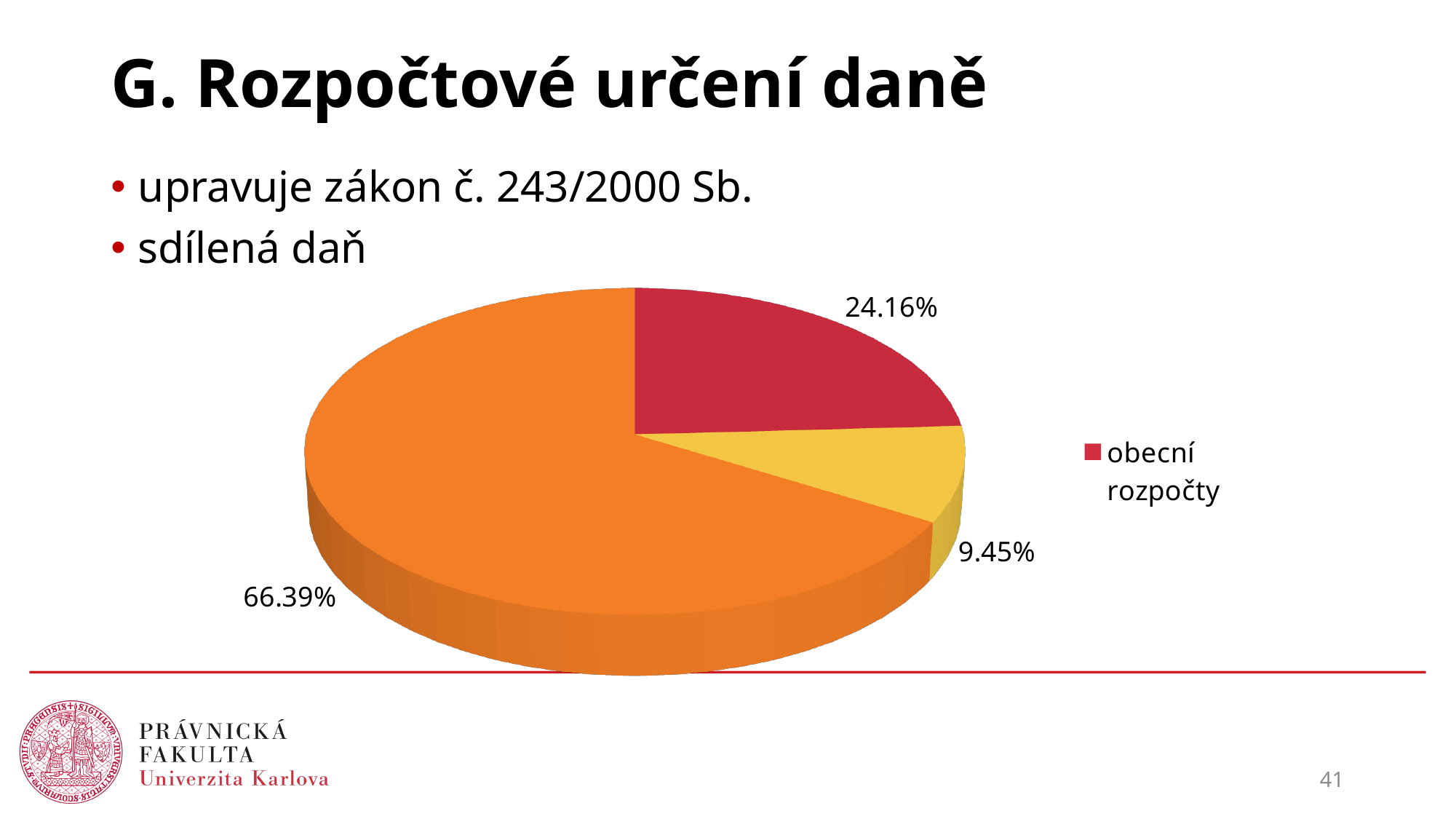
What is the value of the smallest slice of the pie chart? 9.45% Which category is listed in the chart's legend? obecní rozpočty What is the value of the largest slice of the pie chart? 66.39% What colour is the obecní rozpočty slice in the pie chart? red Which is larger: the obecní rozpočty slice or the yellow slice? obecní rozpočty What is the difference between the largest slice (66.39%) and the obecní rozpočty slice (24.16%)? 42.23% What percentage of the pie chart is labelled for obecní rozpočty? 24.16% Is the share for obecní rozpočty greater or less than 50%? less What is the difference between the obecní rozpočty slice (24.16%) and the smallest slice (9.45%)? 14.71% How many slices does the pie chart have? 3 What kind of chart is shown on the slide? pie chart What share of the pie does the orange slice represent? 66.39%